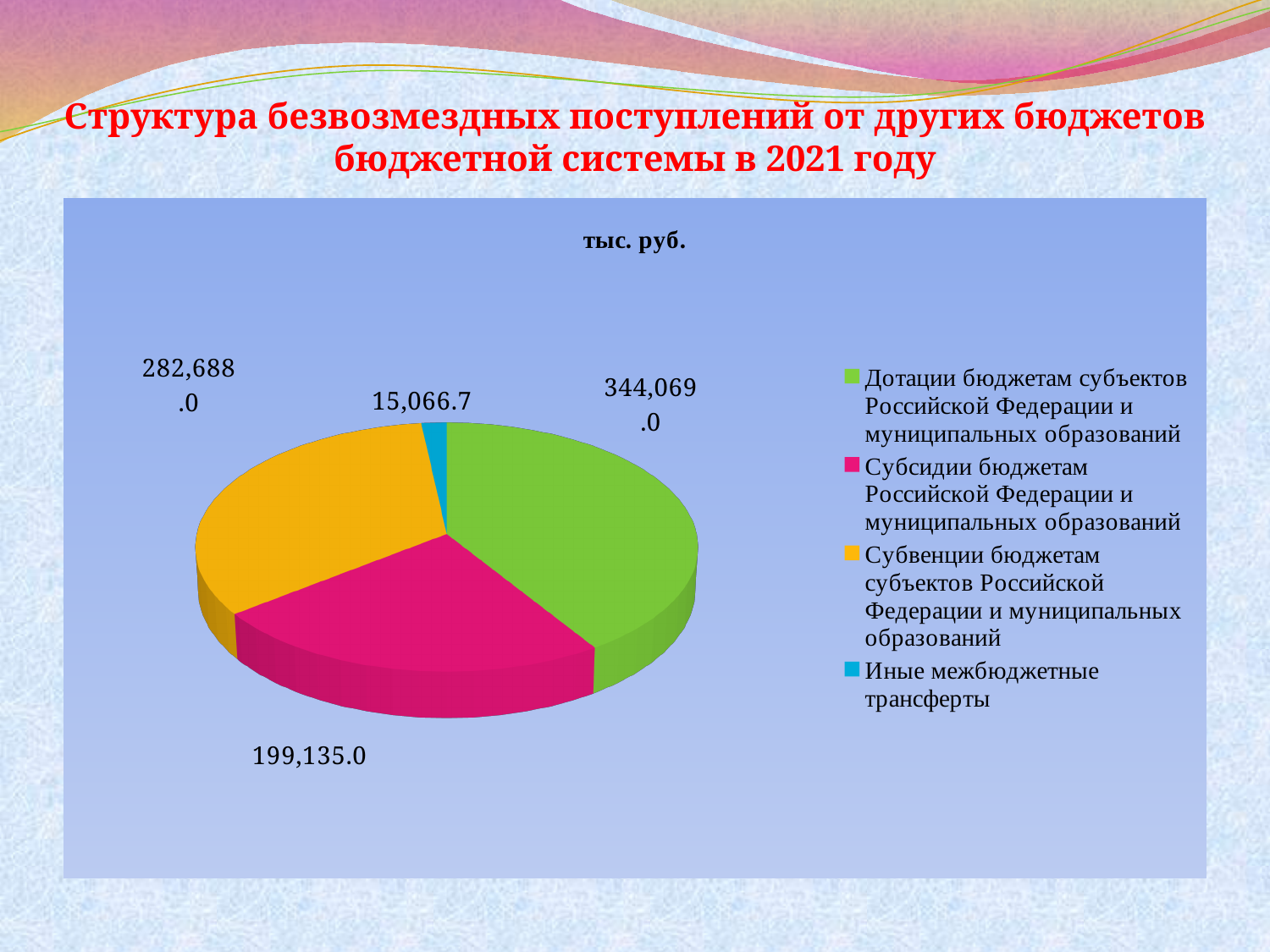
What unit is given in the chart title? тыс. руб. How many categories does the pie chart show? 4 What is the value for Субсидии бюджетам Российской Федерации и муниципальных образований? 199,135.0 Which is larger: the value for Субвенции or the value for Субсидии? Субвенции What type of chart is shown on the slide? Pie chart What is the difference between the values for Дотации and Субвенции? 61,381.0 Which category has the smallest slice of the pie? Иные межбюджетные трансферты What is the value for Субвенции бюджетам субъектов Российской Федерации и муниципальных образований? 282,688.0 What is the value for Иные межбюджетные трансферты? 15,066.7 What colour is the slice for Иные межбюджетные трансферты? Blue What is the value for Дотации бюджетам субъектов Российской Федерации и муниципальных образований? 344,069.0 Which category has the largest slice of the pie? Дотации бюджетам субъектов Российской Федерации и муниципальных образований